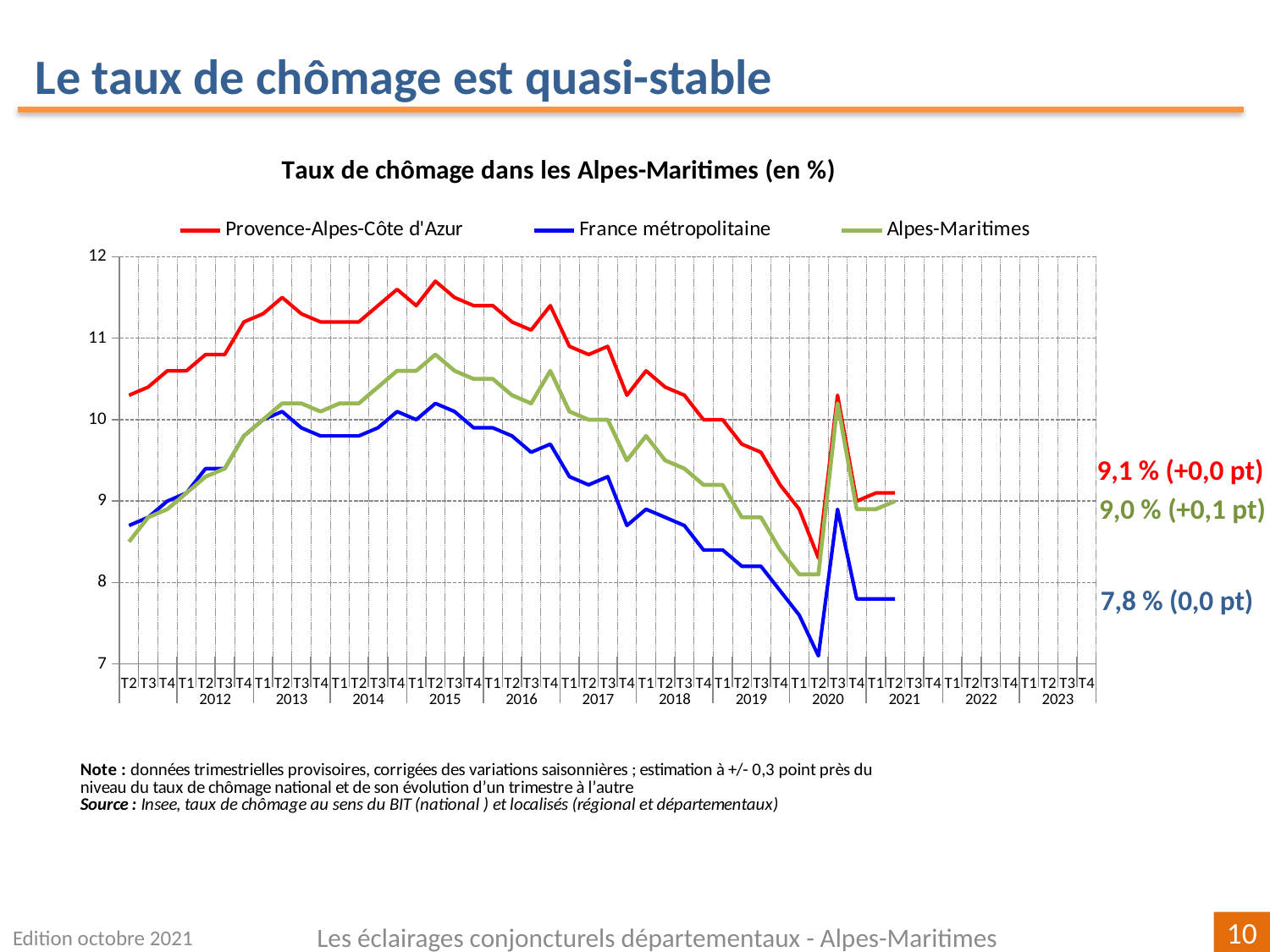
What is the latest unemployment rate shown for Provence-Alpes-Côte d'Azur? 9,1 % What is the difference between the latest values for Provence-Alpes-Côte d'Azur and France métropolitaine? 1,3 points What is the latest unemployment rate shown for France métropolitaine? 7,8 % Between 2016 and early 2020, do the unemployment rates generally rise or fall? fall What is the latest unemployment rate shown for Alpes-Maritimes? 9,0 % Is the peak value for Provence-Alpes-Côte d'Azur in 2015 greater or less than 11? greater How many series does the legend list? 3 Which series has the highest value at the end of the chart? Provence-Alpes-Côte d'Azur At the latest point, which is larger: the rate for Alpes-Maritimes or the rate for France métropolitaine? Alpes-Maritimes Is the value for France métropolitaine in T2 2020 greater or less than 8? less What kind of chart is shown on the slide? line chart